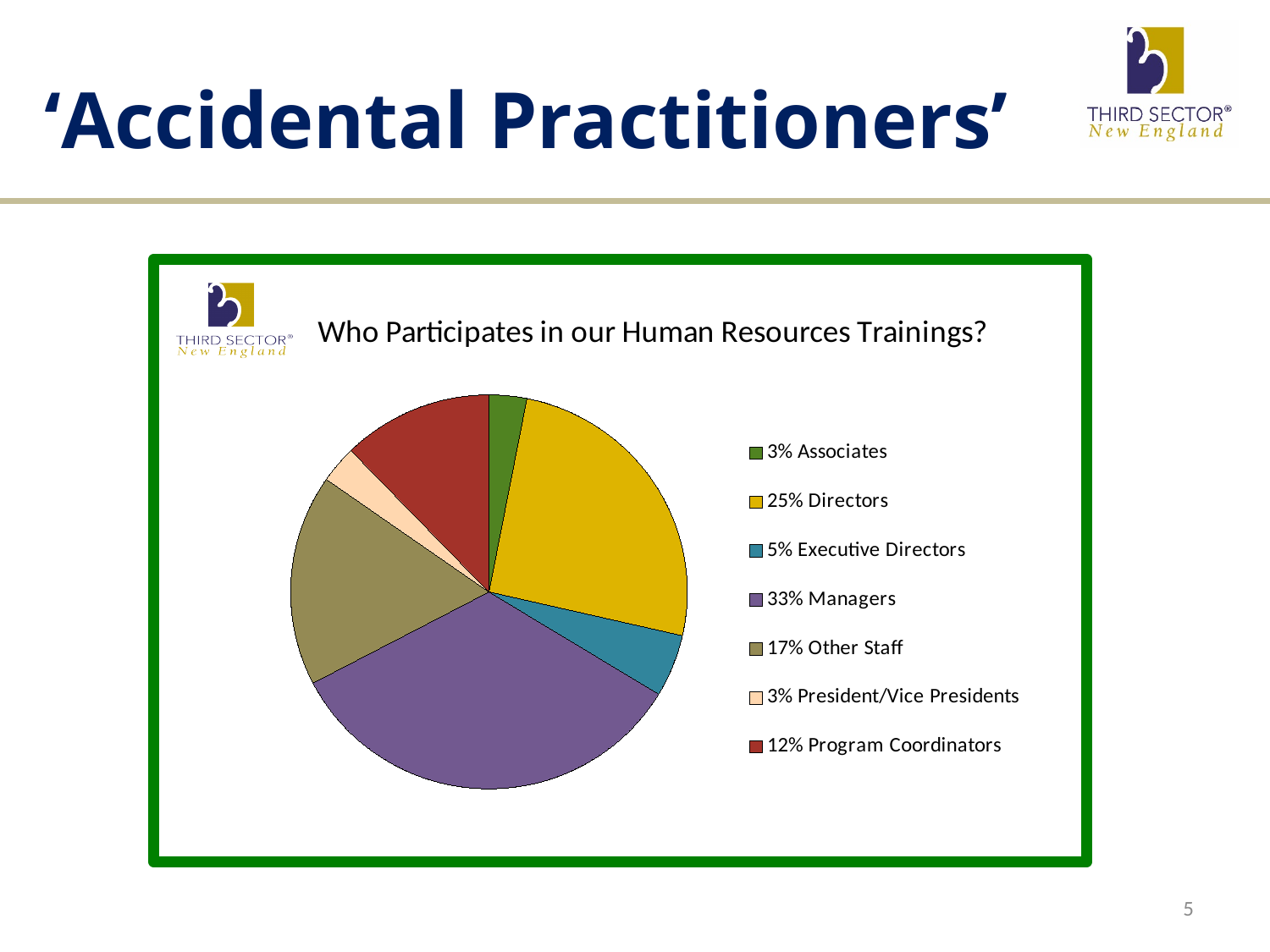
What share of participants are Managers? 33% What share of participants are Executive Directors? 5% Which is larger, the share for Other Staff or the share for Program Coordinators? Other Staff What is the difference in percentage points between Managers and Directors? 8 Which two categories share the smallest percentage? Associates and President/Vice Presidents What is the title of the chart? Who Participates in our Human Resources Trainings? How many categories does the legend list? 7 What share of participants are Program Coordinators? 12% Which category has the largest share of the pie? Managers What kind of chart is shown on the slide? pie chart What colour is the Managers slice? purple What share of participants are Directors? 25%